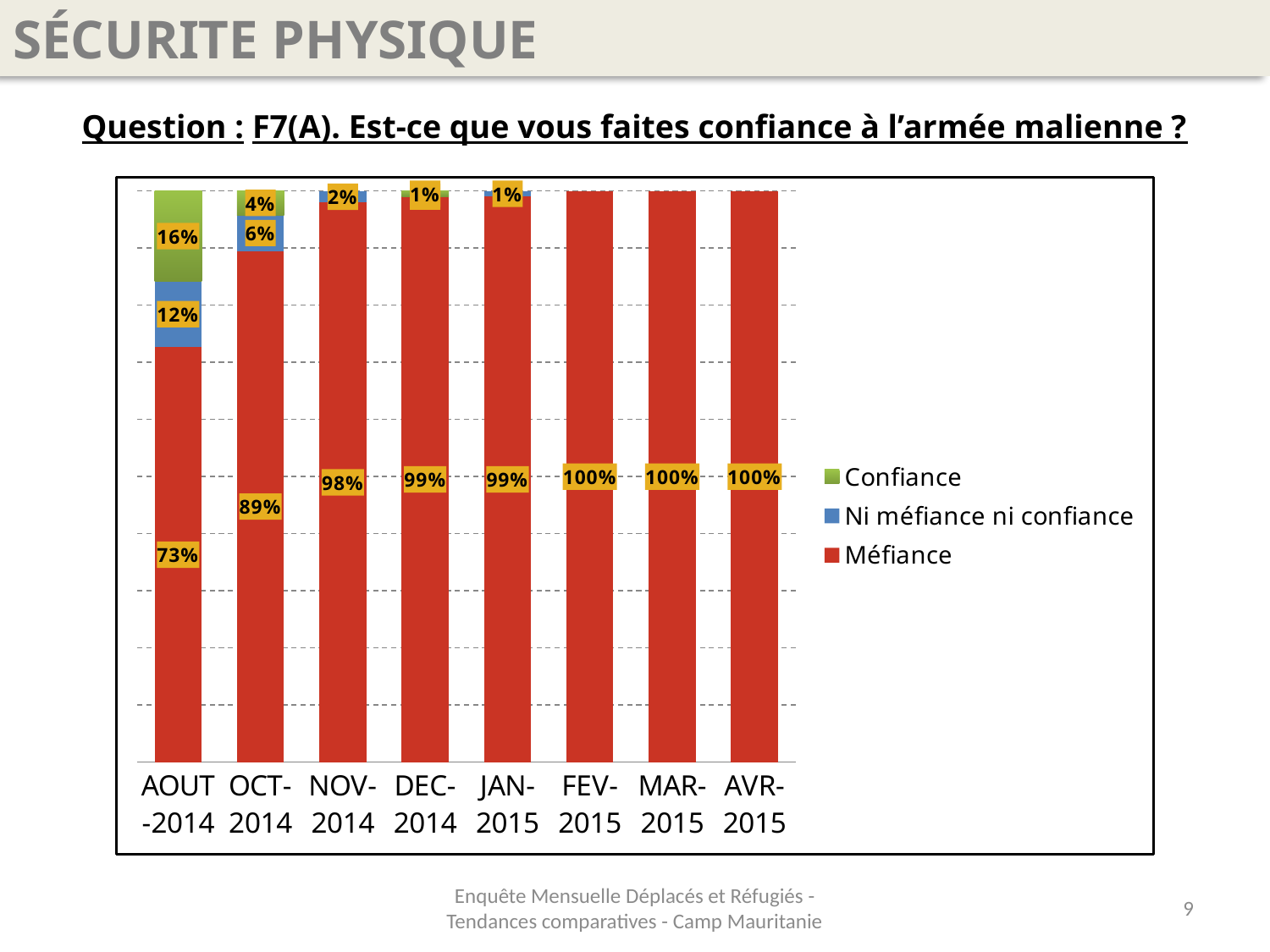
What is the Méfiance value for AOUT-2014? 73% What is the Confiance value for AOUT-2014? 16% How many months (categories) are shown on the x axis? 8 What is the Méfiance value for MAR-2015? 100% What is the difference between the Méfiance values for OCT-2014 and AOUT-2014? 16% Is the Confiance value for AOUT-2014 larger or smaller than the Confiance value for OCT-2014? Larger How many series does the legend list? 3 What is the Ni méfiance ni confiance value for OCT-2014? 6% Does the Méfiance value rise or fall from AOUT-2014 to AVR-2015? Rises Which month has the lowest Méfiance value? AOUT-2014 What is the Méfiance value for NOV-2014? 98% What kind of chart is shown on the slide? Stacked bar chart